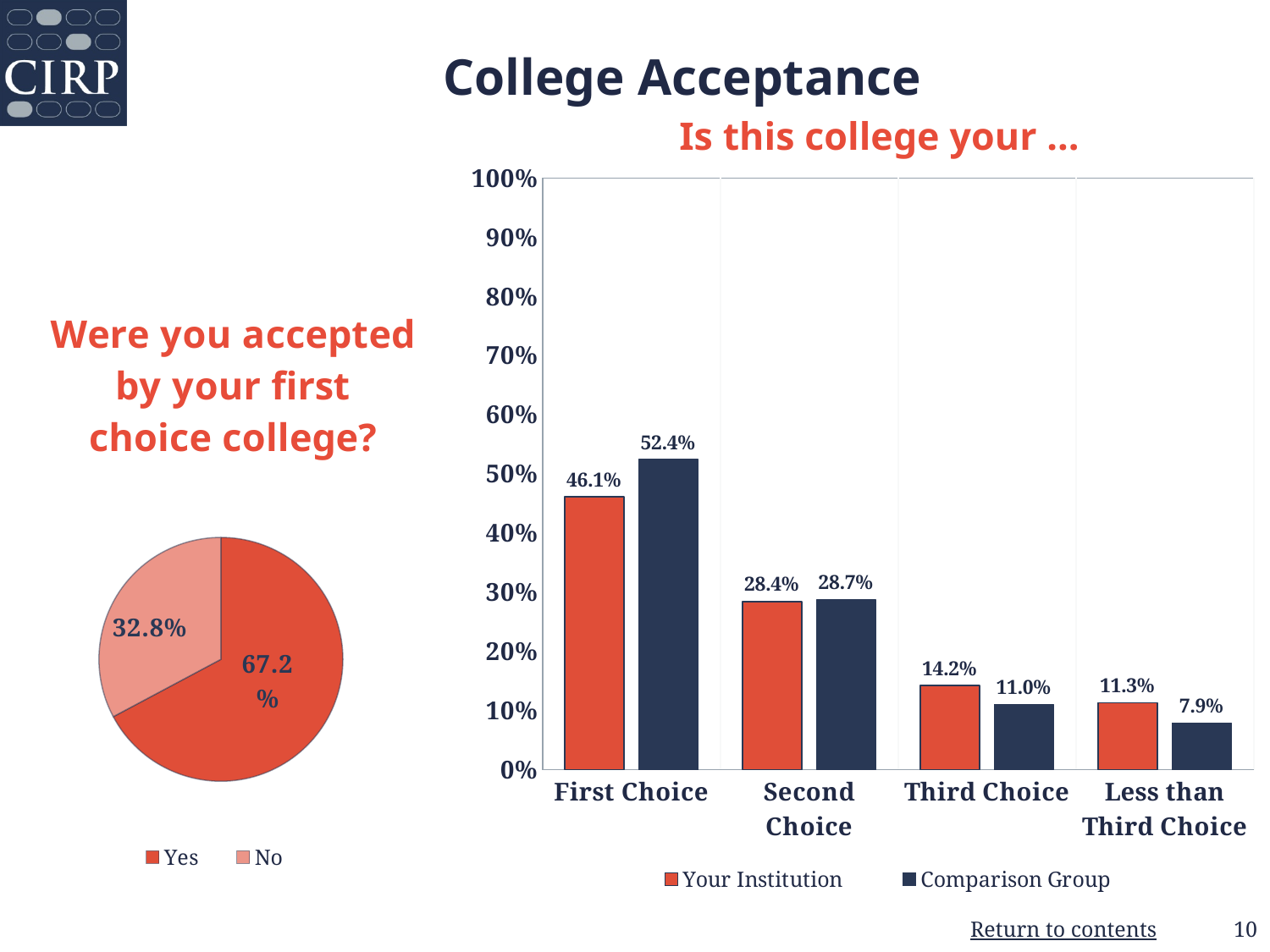
In the bar chart 'Is this college your ...', which category has the lowest value for Your Institution? Less than Third Choice In the bar chart 'Is this college your ...', how many categories are shown on the x axis? 4 In the bar chart 'Is this college your ...', what is the difference between Comparison Group and Your Institution for First Choice? 6.3% In the bar chart 'Is this college your ...', what is the value for Comparison Group for Less than Third Choice? 7.9% What kind of chart is the chart titled 'Were you accepted by your first choice college?'? pie chart In the bar chart 'Is this college your ...', do the Your Institution values rise or fall from First Choice to Less than Third Choice? fall What kind of chart is the chart titled 'Is this college your ...'? bar chart In the bar chart 'Is this college your ...', how many series does the legend list? 2 In the bar chart 'Is this college your ...', which is larger for Third Choice: Your Institution or Comparison Group? Your Institution In the bar chart 'Is this college your ...', which category has the highest value for Comparison Group? First Choice In the pie chart 'Were you accepted by your first choice college?', what share of the pie is Yes? 67.2% In the bar chart 'Is this college your ...', what is the value for Your Institution for First Choice? 46.1%